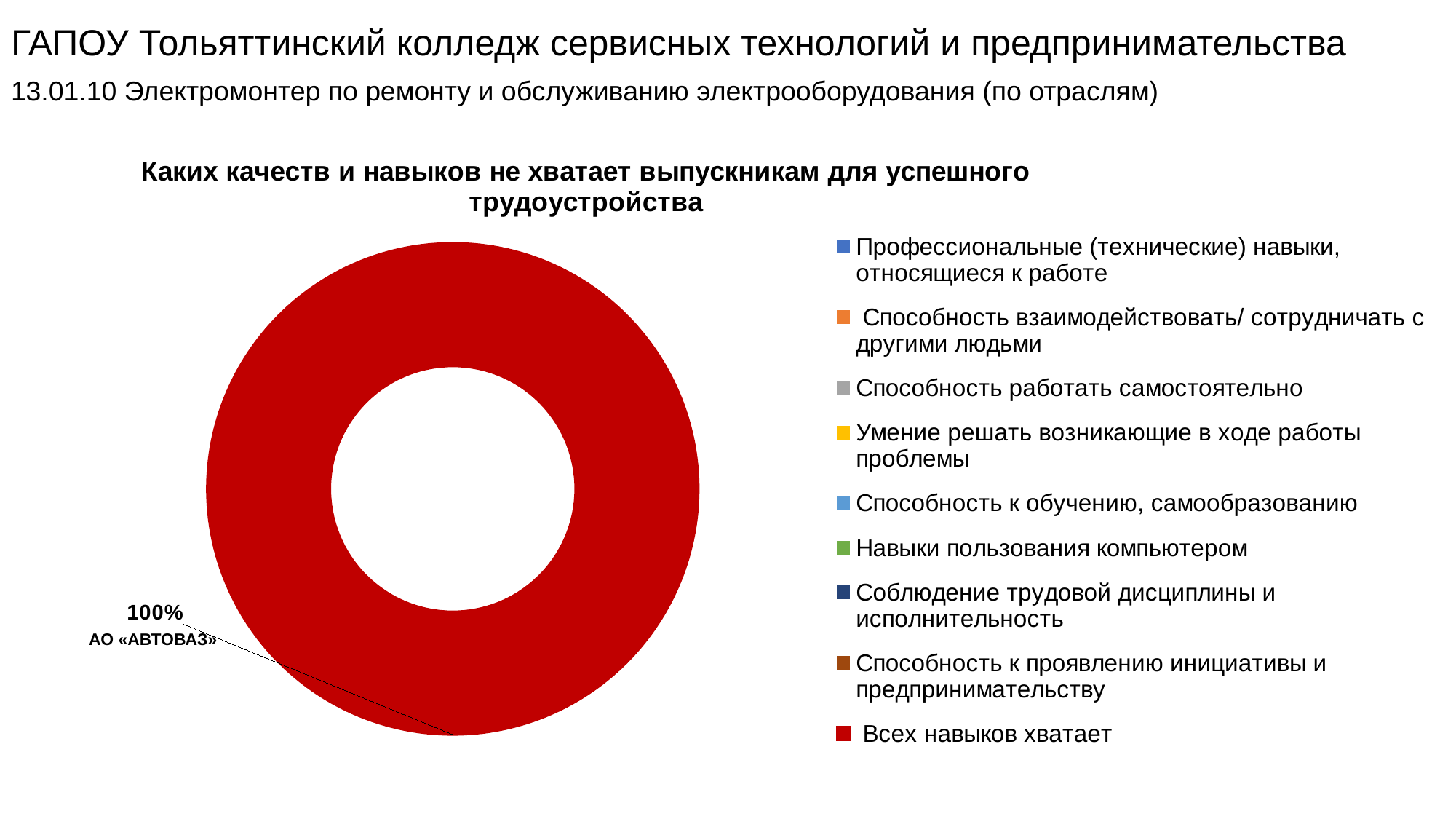
Is the value for 'Всех навыков хватает' greater or less than 50%? greater What kind of chart is shown on the slide? Doughnut (pie) chart Which legend category does the red slice that fills the whole chart correspond to? Всех навыков хватает Which employer name is printed next to the 100% data label? АО «АВТОВАЗ» What is the title of the chart? Каких качеств и навыков не хватает выпускникам для успешного трудоустройства How many entries does the chart legend list? 9 What share of the chart does the category 'Всех навыков хватает' take? 100% How many slices are visibly plotted in the chart? 1 Which is larger in the chart: the share for 'Всех навыков хватает' or the share for 'Навыки пользования компьютером'? Всех навыков хватает What percentage is shown on the data label of the chart? 100%